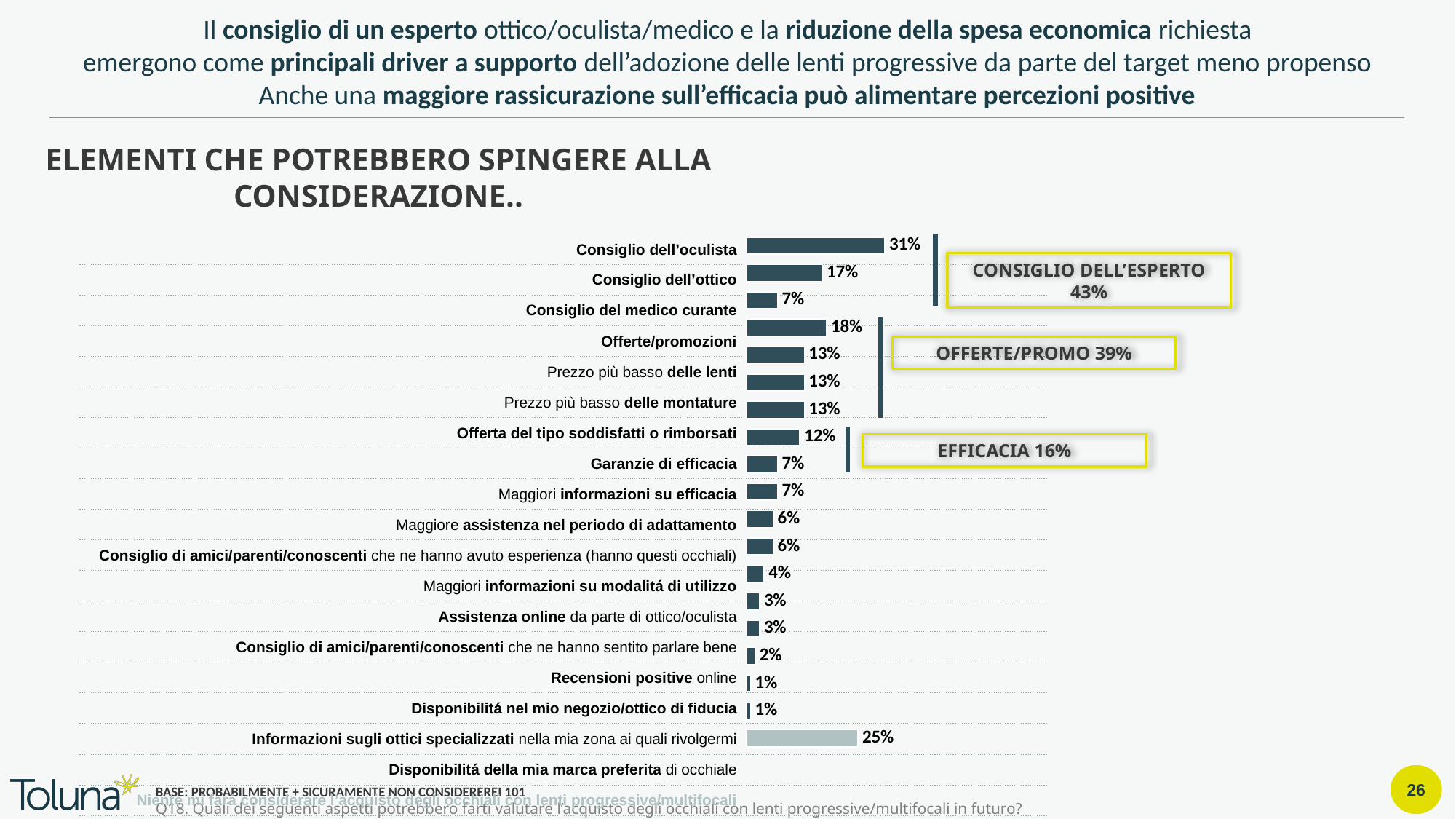
Which category has the highest value in the chart? Consiglio dell'oculista What is the difference between the values for "Consiglio dell'oculista" and "Consiglio dell'ottico"? 14 percentage points What percentage is shown in the "CONSIGLIO DELL'ESPERTO" callout box? 43% Which is larger, the value for "Consiglio dell'oculista" or the value of the grey bar? Consiglio dell'oculista What is the lowest value shown on any bar in the chart? 1% What is the value shown for "Consiglio dell'ottico"? 17% Is the value for "Consiglio dell'oculista" greater or less than 30%? greater What percentage is shown in the "OFFERTE/PROMO" callout box? 39% How many bars are plotted in the chart? 19 What type of chart is shown on the slide? Bar chart What is the value shown for "Consiglio dell'oculista"? 31% What is the value of the grey bar at the bottom of the chart? 25%